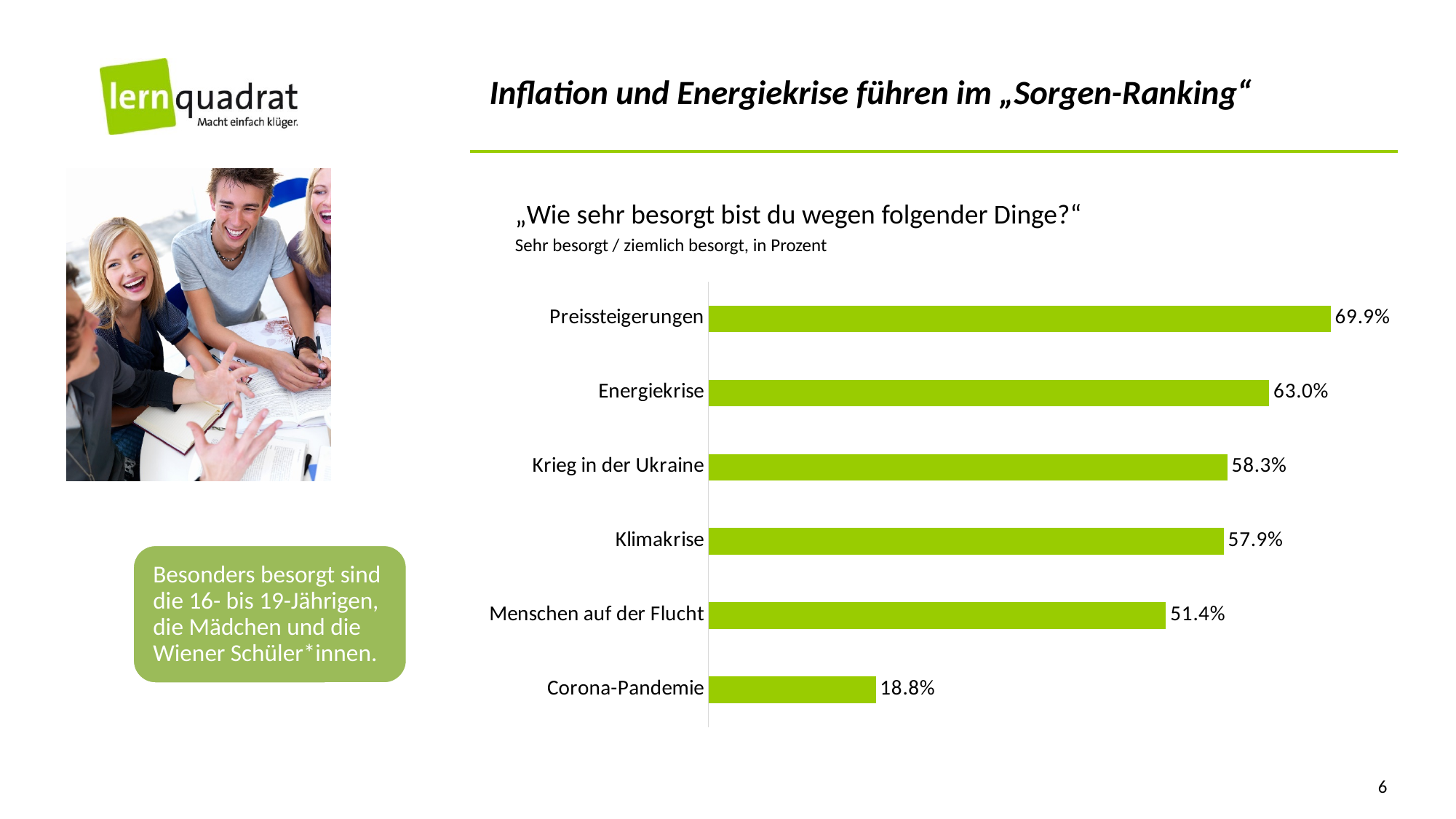
Which category has the lowest value? Corona-Pandemie How many categories are shown in the chart? 6 What question is the chart based on, as shown above the chart? „Wie sehr besorgt bist du wegen folgender Dinge?“ What is the value for Corona-Pandemie? 18.8% Which is larger, the value for Energiekrise or the value for Menschen auf der Flucht? Energiekrise What is the difference between the values for Krieg in der Ukraine and Klimakrise? 0.4% What is the difference between the values for Preissteigerungen and Energiekrise? 6.9% What is the value for Preissteigerungen? 69.9% Which category has the highest value? Preissteigerungen What kind of chart is shown on the slide? Bar chart What is the value for Energiekrise? 63.0% What is the value for Menschen auf der Flucht? 51.4%